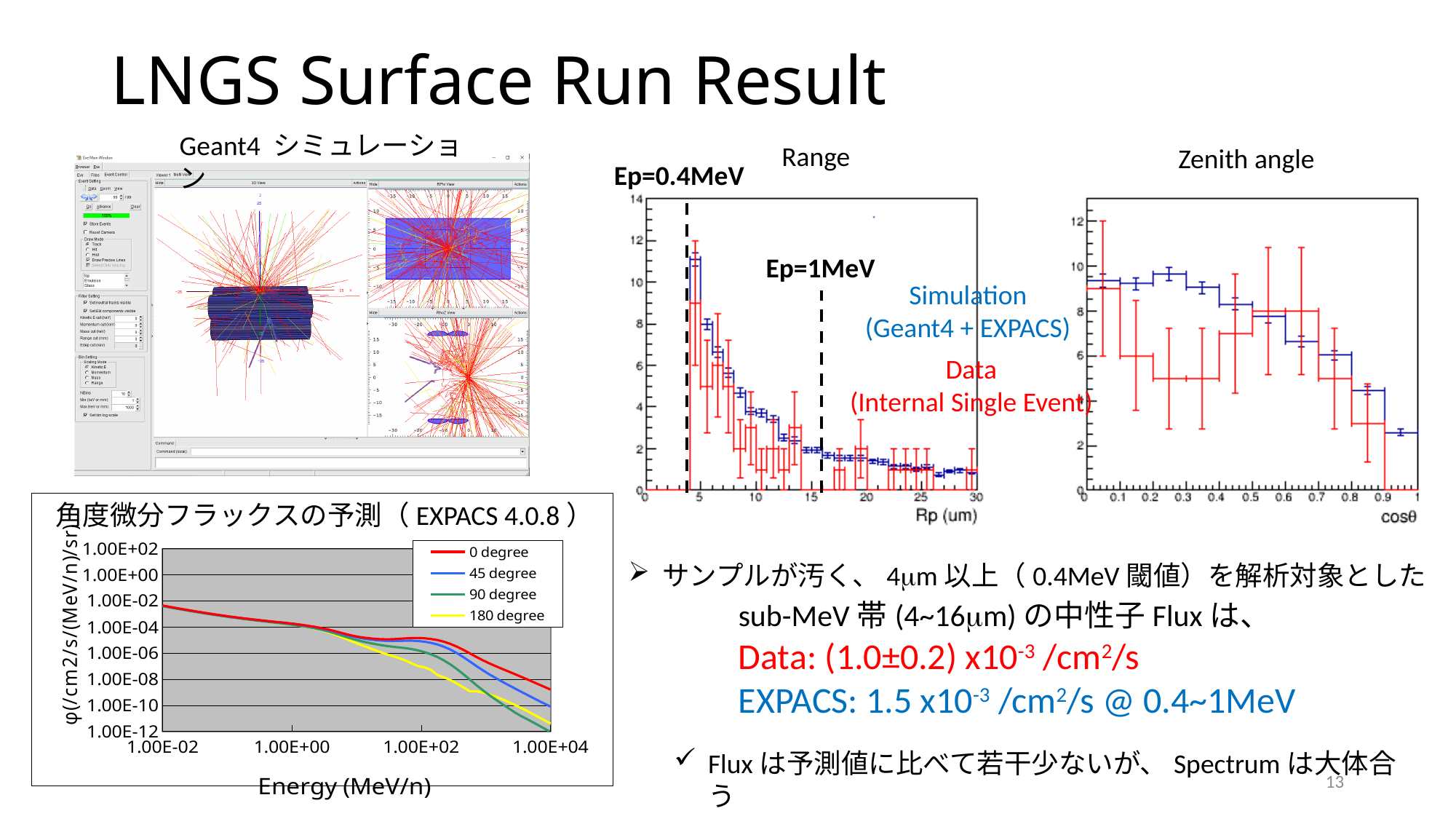
In the bottom-left EXPACS chart, which series is drawn in yellow? 180 degree In the Range chart, is the Simulation value at Rp = 5 um greater or less than 8? greater What kind of chart is the bottom-left chart titled 角度微分フラックスの予測 (EXPACS 4.0.8)? line chart In the bottom-left EXPACS chart, which series has the highest flux at the right end of the x axis (1.00E+04 MeV/n)? 0 degree What is the x-axis label of the bottom-left EXPACS chart? Energy (MeV/n) How many series does the legend of the bottom-left EXPACS chart list? 4 In the Zenith angle chart, is the Simulation value at cosθ = 0.95 greater or less than 4? less In the Range chart, do the values rise or fall as Rp increases along the x axis? fall In the Zenith angle chart, do the values rise or fall as cosθ increases along the x axis? fall In the bottom-left EXPACS chart, do the flux values rise or fall as energy increases along the x axis? fall In the Range chart, what is the x-axis label? Rp (um) In the bottom-left EXPACS chart, which series has the lowest flux at the right end of the x axis (1.00E+04 MeV/n)? 90 degree